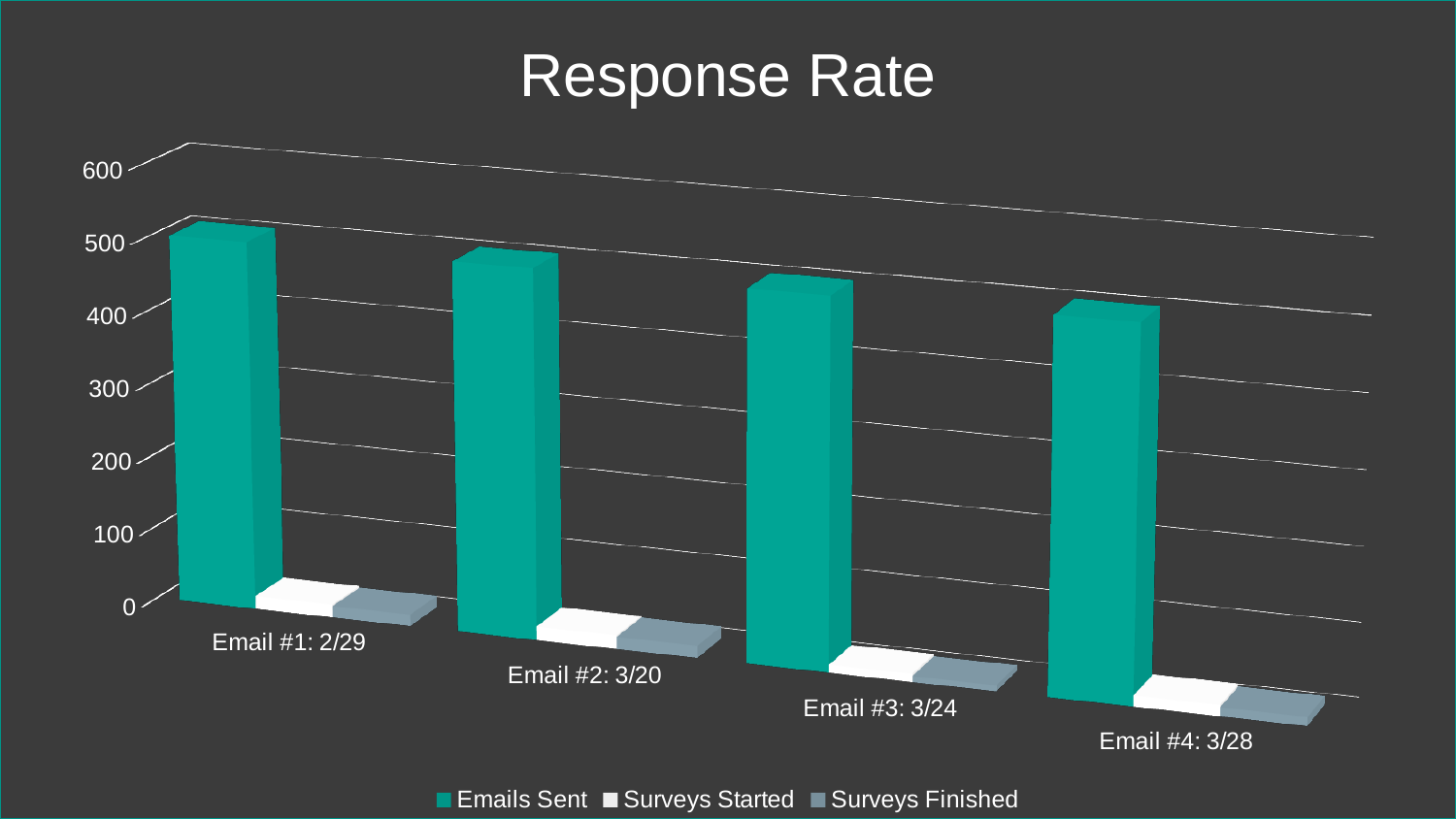
Which email has the highest value for Emails Sent? Email #1: 2/29 Which series is shown in teal in the legend? Emails Sent How many series does the legend list? 3 Is the Emails Sent value for Email #1: 2/29 greater or less than 400? greater What is the title of the chart? Response Rate Which is larger, Emails Sent for Email #1: 2/29 or Emails Sent for Email #4: 3/28? Email #1: 2/29 How many email categories are shown on the x axis? 4 What kind of chart is shown on the slide? bar chart Is the Surveys Started value for Email #1: 2/29 greater or less than 100? less Do the Emails Sent values rise or fall from Email #1 to Email #4? fall